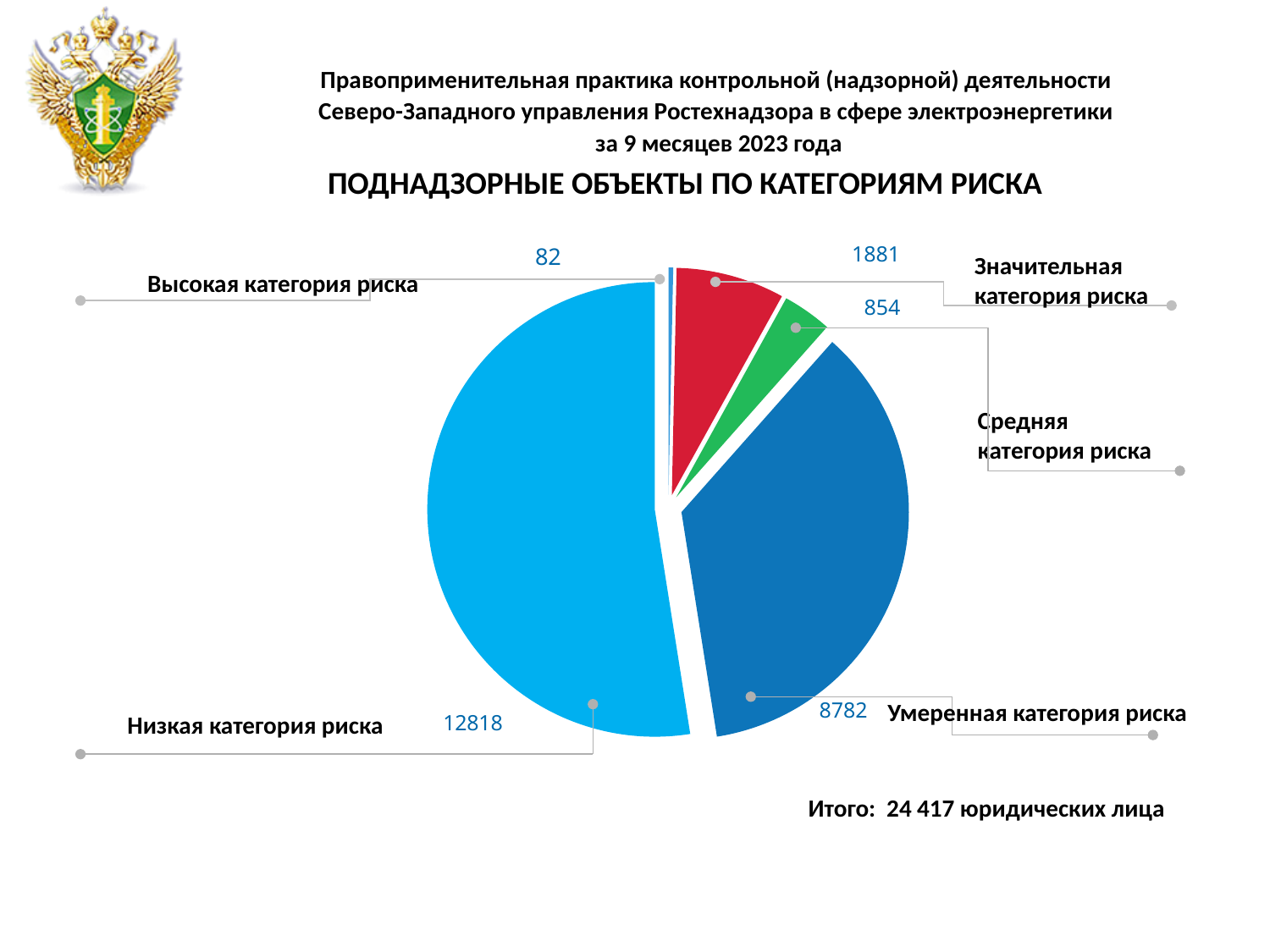
Which category has the smallest slice? Высокая категория риска How many categories does the pie chart show? 5 What is the difference between Низкая категория риска and Умеренная категория риска? 4036 What is the value for Значительная категория риска? 1881 Which category has the largest slice? Низкая категория риска What type of chart is shown on the slide? Pie chart What is the value for Низкая категория риска? 12818 Which is larger, Значительная категория риска or Средняя категория риска? Значительная категория риска What is the value for Умеренная категория риска? 8782 What is the total stated on the slide for all categories? 24 417 юридических лица What is the value for Высокая категория риска? 82 What is the value for Средняя категория риска? 854